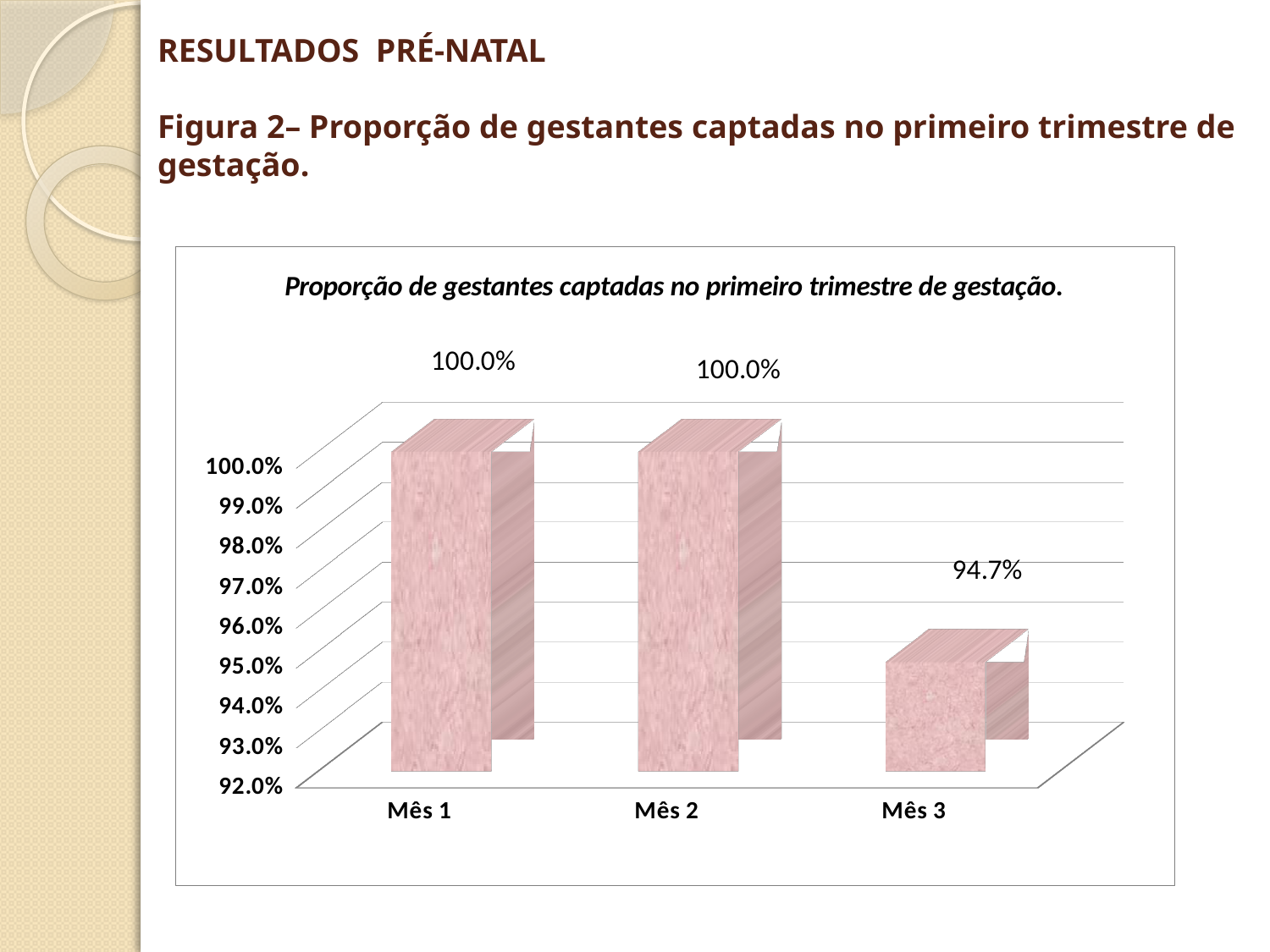
Which is larger, the value for Mês 2 or the value for Mês 3? Mês 2 Do the values rise or fall from Mês 2 to Mês 3? fall How many categories are shown on the x axis? 3 What is the title of the chart? Proporção de gestantes captadas no primeiro trimestre de gestação. What is the lowest value shown on the y axis? 92.0% What is the difference between the values for Mês 1 and Mês 3? 5.3% Which month has the lowest value? Mês 3 What is the value for Mês 2? 100.0% What is the value for Mês 3? 94.7% What kind of chart is shown on the slide? bar chart What is the value for Mês 1? 100.0% Is the value for Mês 3 greater or less than 96.0%? less